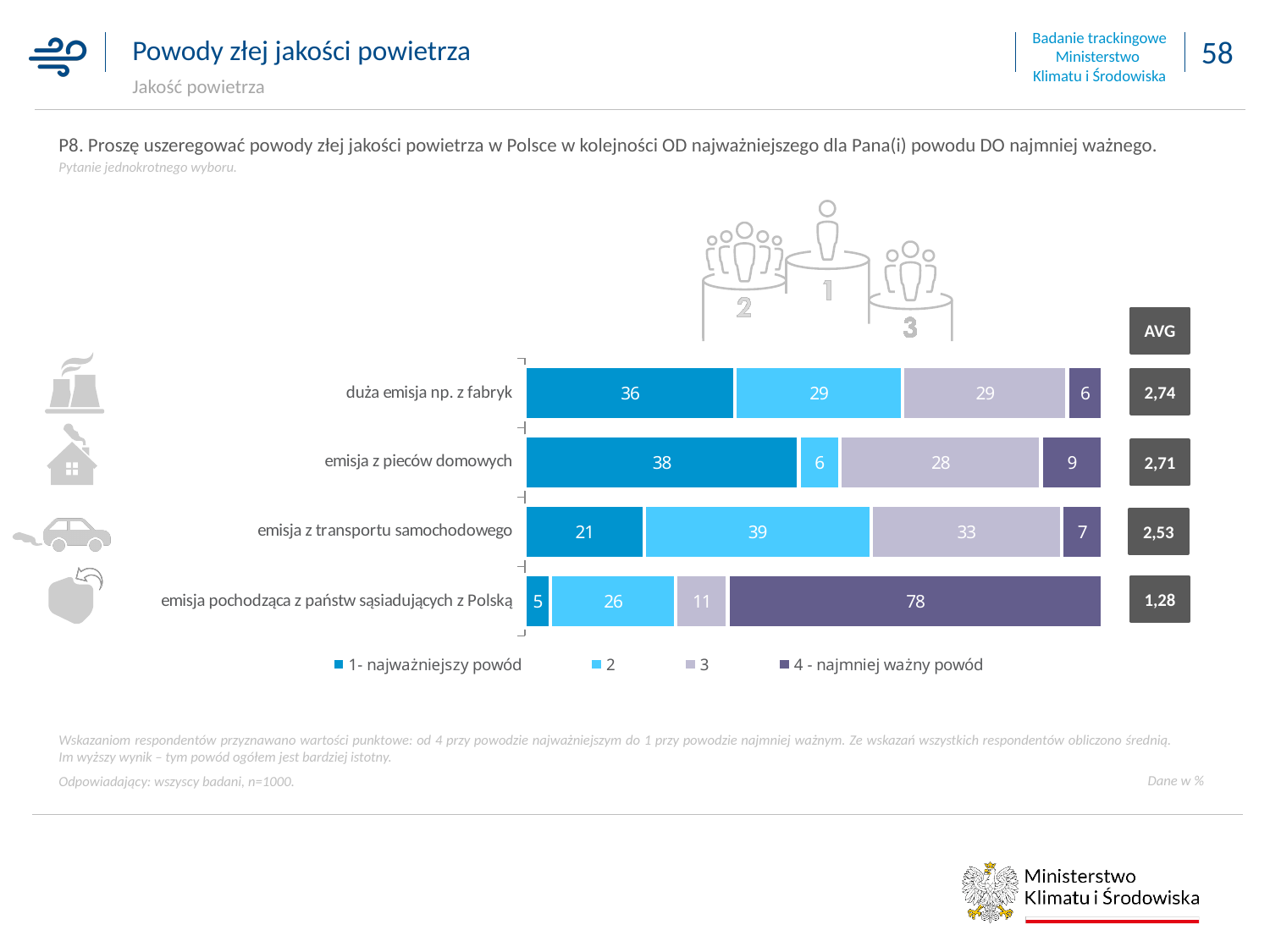
What kind of chart is shown on the slide? Stacked bar chart What is the value of "1- najważniejszy powód" for "duża emisja np. z fabryk"? 36 What is the AVG value shown for "emisja z transportu samochodowego"? 2,53 Which category has the lowest value for "1- najważniejszy powód"? emisja pochodząca z państw sąsiadujących z Polską Which has the larger "3" value: "emisja z transportu samochodowego" or "duża emisja np. z fabryk"? emisja z transportu samochodowego What is the difference between the "2" value for "emisja z transportu samochodowego" and the "2" value for "emisja z pieców domowych"? 33 How many series does the chart legend list? 4 Which category has the highest value for "4 - najmniej ważny powód"? emisja pochodząca z państw sąsiadujących z Polską How many categories (reasons) are plotted in the chart? 4 Which category has the highest value for "1- najważniejszy powód"? emisja z pieców domowych What is the value of "4 - najmniej ważny powód" for "emisja pochodząca z państw sąsiadujących z Polską"? 78 What is the first entry in the chart legend? 1- najważniejszy powód